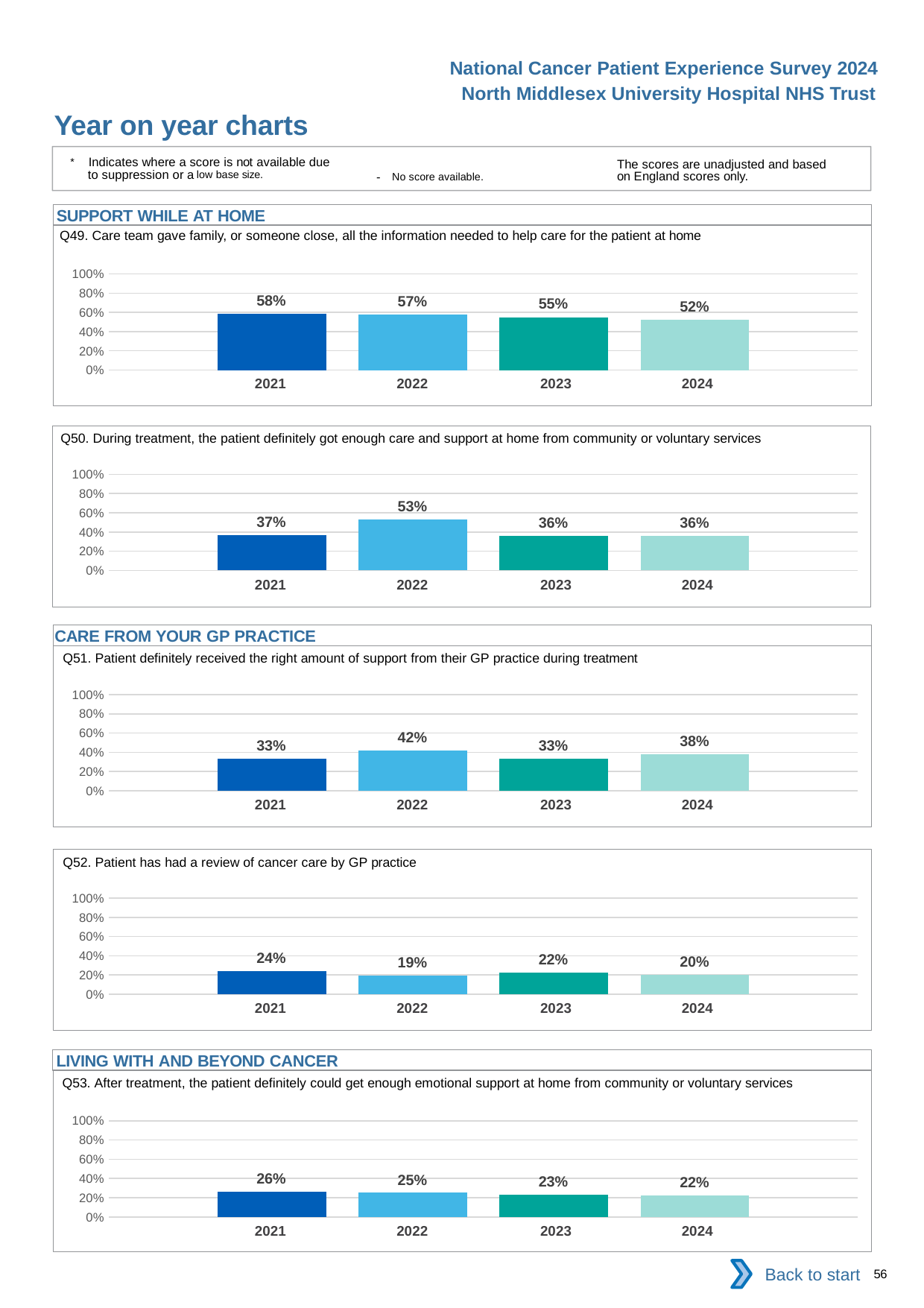
In the Q49 chart, what is the value for 2021? 58% Which section heading appears above the Q51 chart? CARE FROM YOUR GP PRACTICE In the Q53 chart, what is the value for 2023? 23% In the Q50 chart, which year has the highest value? 2022 In the Q52 chart, which year has the lowest value? 2022 In the Q53 chart, how many years are plotted? 4 In the Q51 chart, which is larger, the value for 2022 or the value for 2023? 2022 In the Q50 chart, what is the difference between the 2022 and 2021 values? 16% In the Q52 chart, what is the difference between the 2021 and 2024 values? 4% What kind of chart is the Q52 chart? bar chart In the Q49 chart, do the values rise or fall from 2021 to 2024? fall In the Q51 chart, what is the value for 2024? 38%